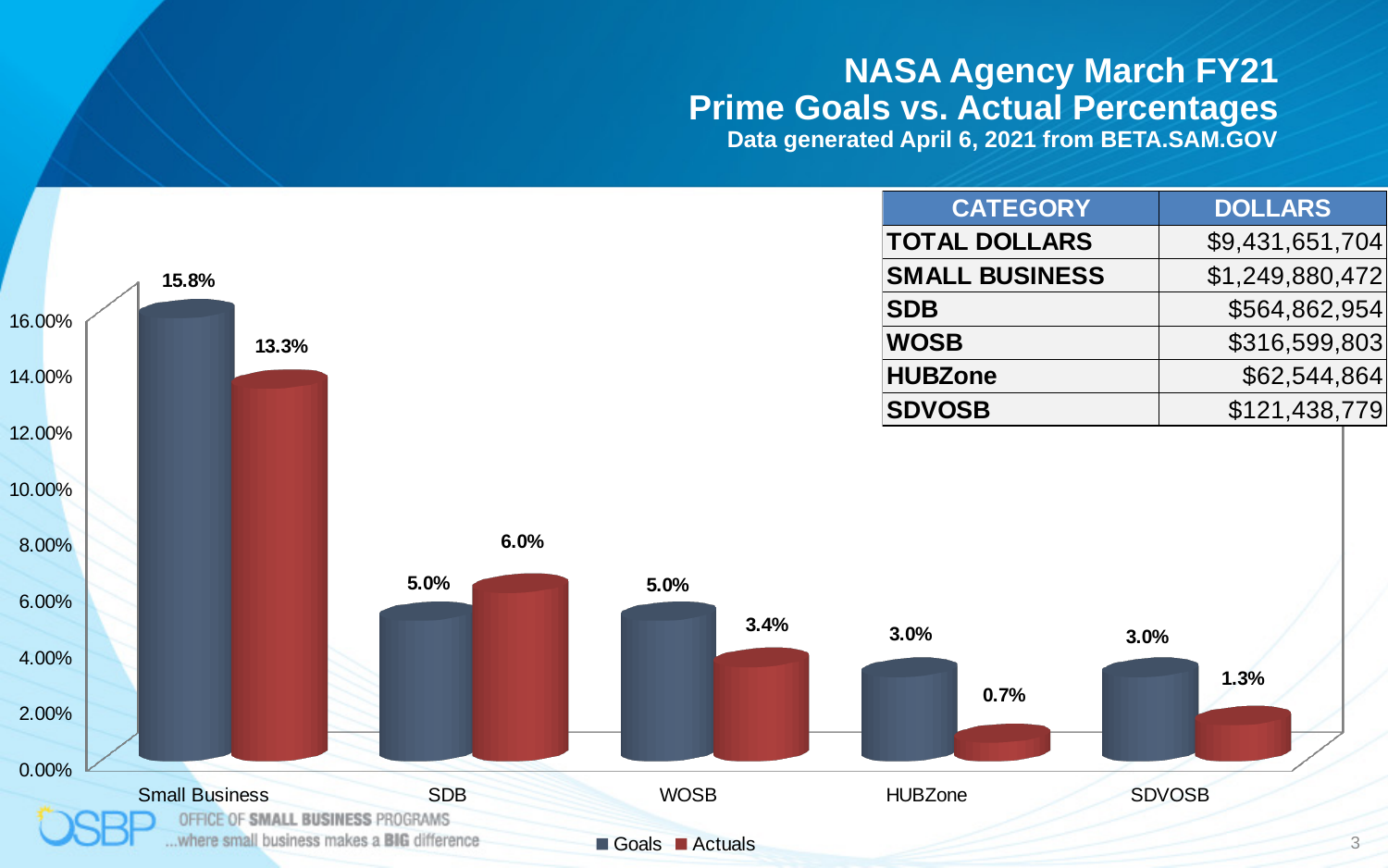
Which category has the highest Actuals value? Small Business Which is larger for SDB, the Goals value or the Actuals value? Actuals What is the difference between the Goals and Actuals values for Small Business? 2.5% How many series does the chart legend list? 2 What kind of chart is shown on the slide? Bar chart What is the Actuals value for HUBZone? 0.7% How many categories are shown on the x axis of the chart? 5 Which category has the lowest Actuals value? HUBZone What is the difference between the Goals and Actuals values for WOSB? 1.6% What is the Goals value for Small Business? 15.8% Is the Actuals value for Small Business greater or less than 12.00%? greater What is the Actuals value for SDB? 6.0%